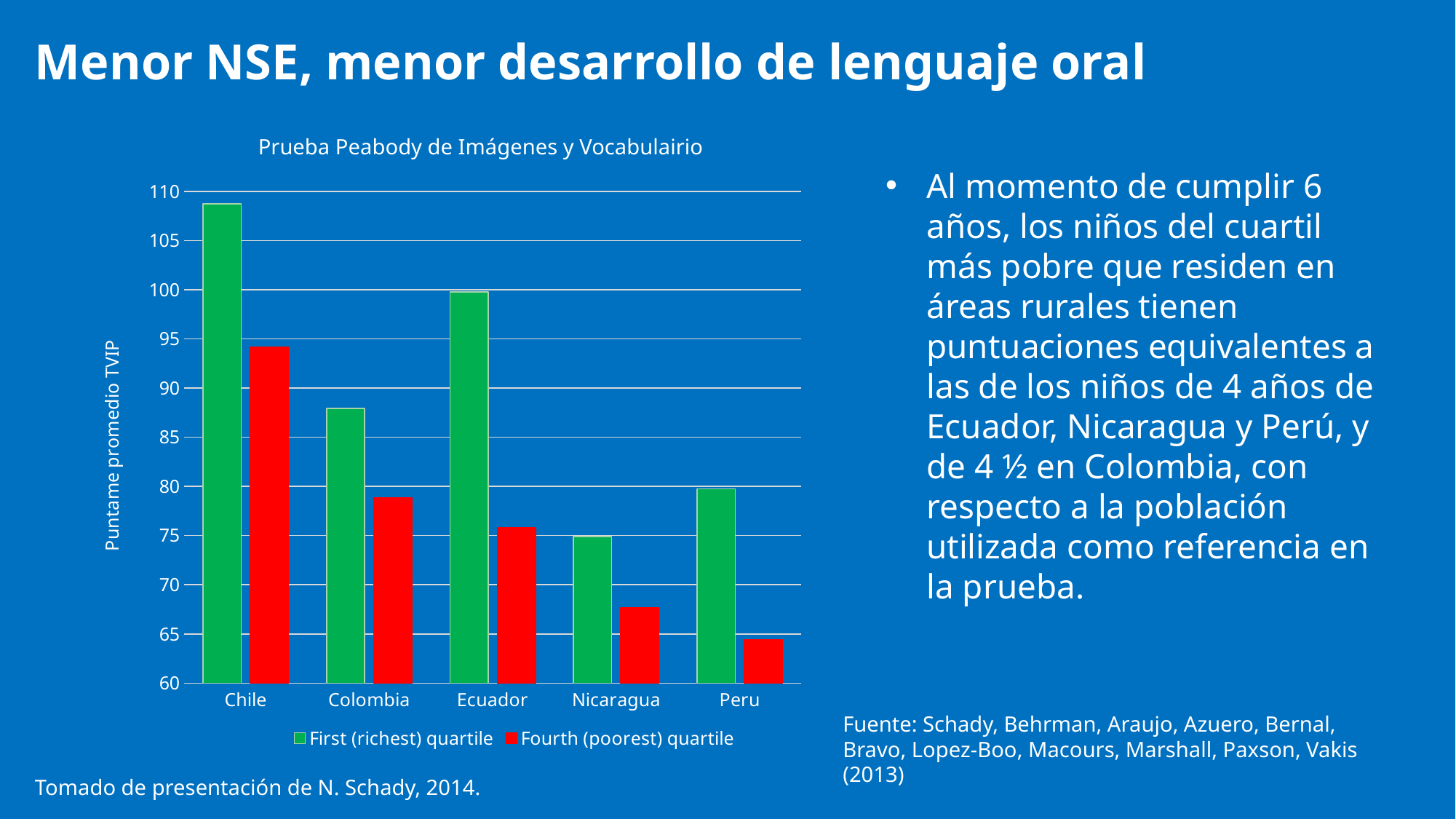
How many series does the chart legend list? 2 How many countries are shown on the x axis of the chart? 5 Is the value for Colombia in the First (richest) quartile series greater or less than 85? greater What is the title of the chart? Prueba Peabody de Imágenes y Vocabulairio Which country has the lowest value for the Fourth (poorest) quartile series? Peru Which country has the lowest value for the First (richest) quartile series? Nicaragua Which country has the highest value for the First (richest) quartile series? Chile What is the label of the vertical axis of the chart? Puntame promedio TVIP Is the value for Chile in the First (richest) quartile series greater or less than 105? greater What kind of chart is shown on the slide? bar chart Which is larger: the Fourth (poorest) quartile value for Chile or the First (richest) quartile value for Colombia? Fourth (poorest) quartile value for Chile Is the value for Peru in the Fourth (poorest) quartile series greater or less than 65? less